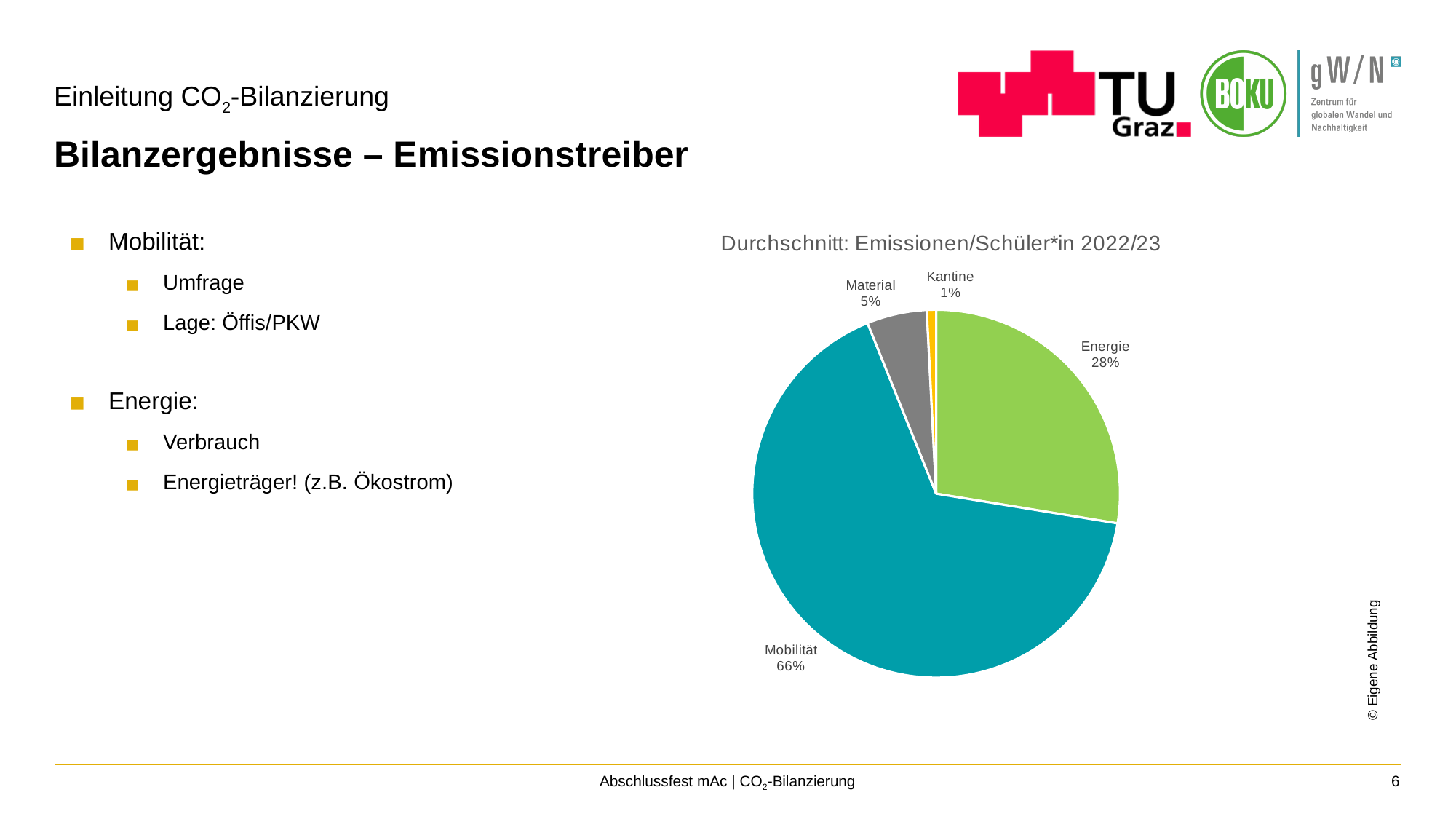
Which category has the largest slice of the pie? Mobilität What is the value shown for Kantine? 1% Which category has the smallest slice of the pie? Kantine What is the title of the chart? Durchschnitt: Emissionen/Schüler*in 2022/23 What colour is the Energie slice? Green How many categories are shown in the pie chart? 4 What is the value shown for Material? 5% What kind of chart is shown on the slide? Pie chart What is the difference in percentage points between Mobilität and Energie? 38 What share of the pie does Mobilität account for? 66% Which is larger, the share for Energie or the share for Material? Energie What share of the pie does Energie account for? 28%